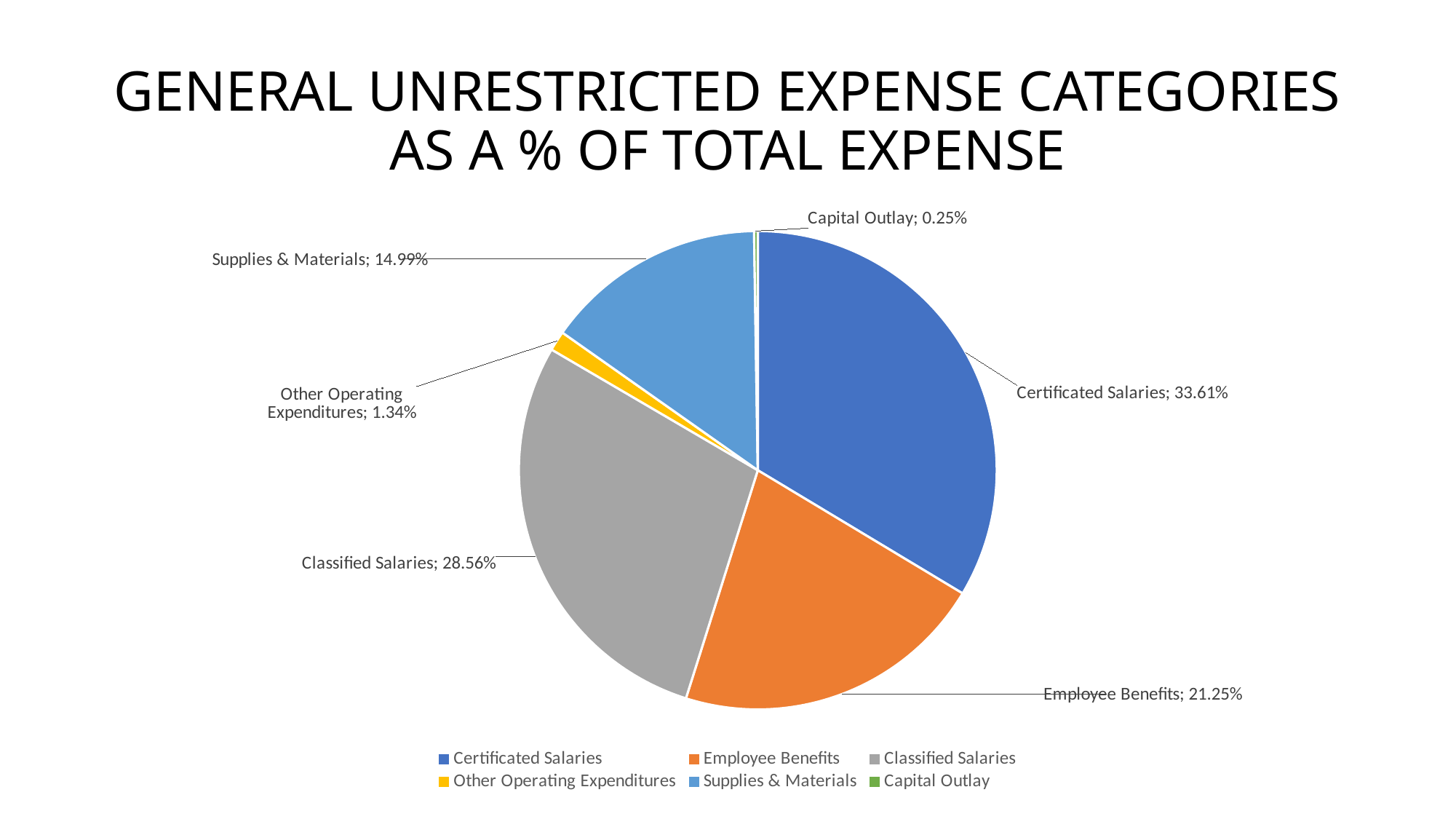
What percentage of total expense is Capital Outlay? 0.25% How many expense categories are shown in the pie chart? 6 What percentage of total expense is Employee Benefits? 21.25% What is the difference in percentage points between Certificated Salaries and Classified Salaries? 5.05% What colour is the Other Operating Expenditures slice? Yellow Which is larger, Employee Benefits or Supplies & Materials? Employee Benefits What percentage of total expense is Classified Salaries? 28.56% What percentage of total expense is Certificated Salaries? 33.61% Which expense category has the smallest share of total expense? Capital Outlay What percentage of total expense is Supplies & Materials? 14.99% What type of chart is shown on the slide? Pie chart Which expense category has the largest share of total expense? Certificated Salaries